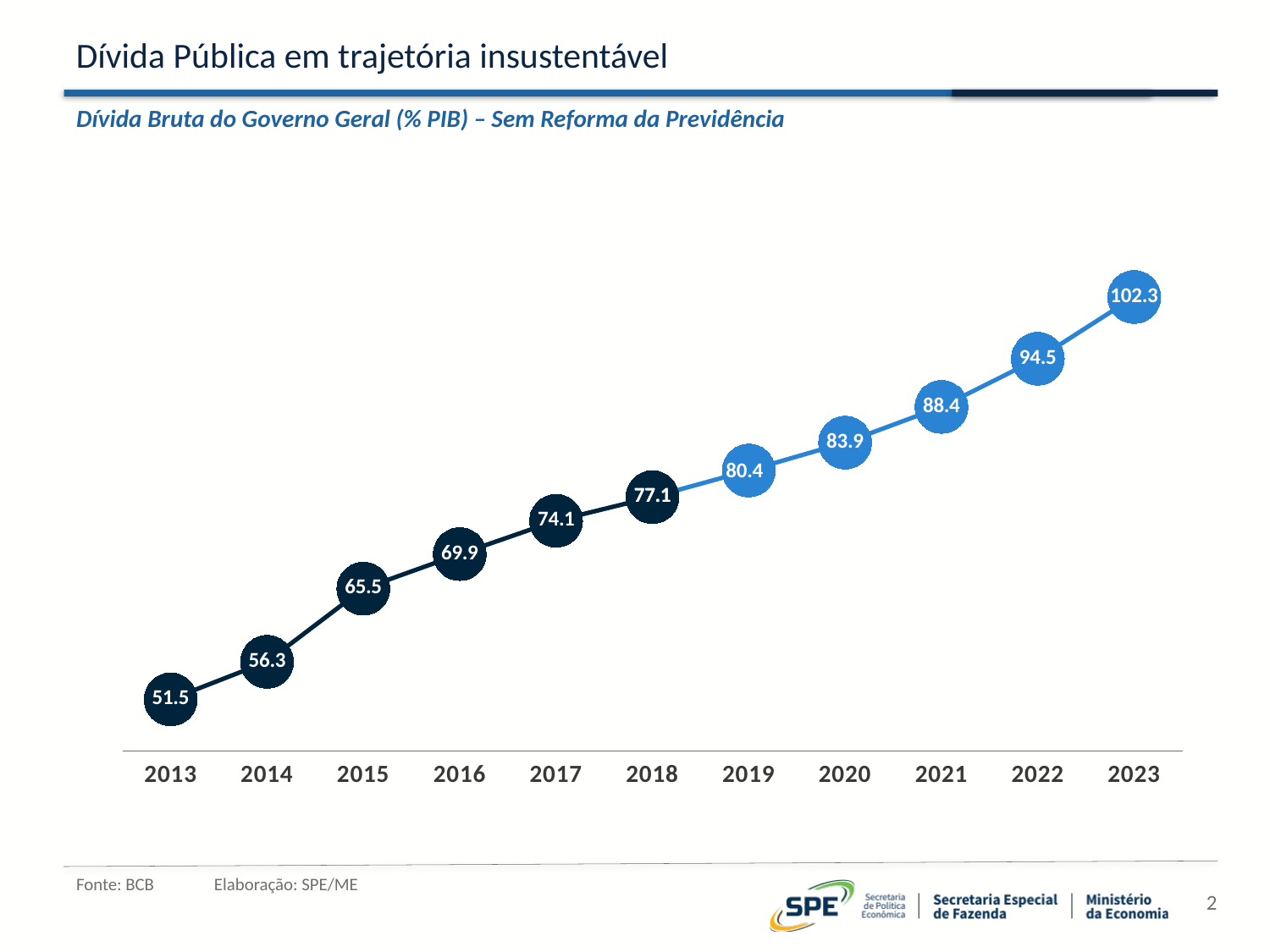
What is the difference between the values for 2023 and 2013? 50.8 What is the value for 2018? 77.1 What is the value for 2023? 102.3 Which is larger, the value for 2016 or the value for 2021? 2021 Which year has the highest value? 2023 What is the value for 2020? 83.9 Do the values rise or fall from 2013 to 2023? rise What is the difference between the values for 2019 and 2018? 3.3 What is the value for 2013? 51.5 What kind of chart is shown? line chart How many years are plotted on the chart? 11 Which year has the lowest value? 2013